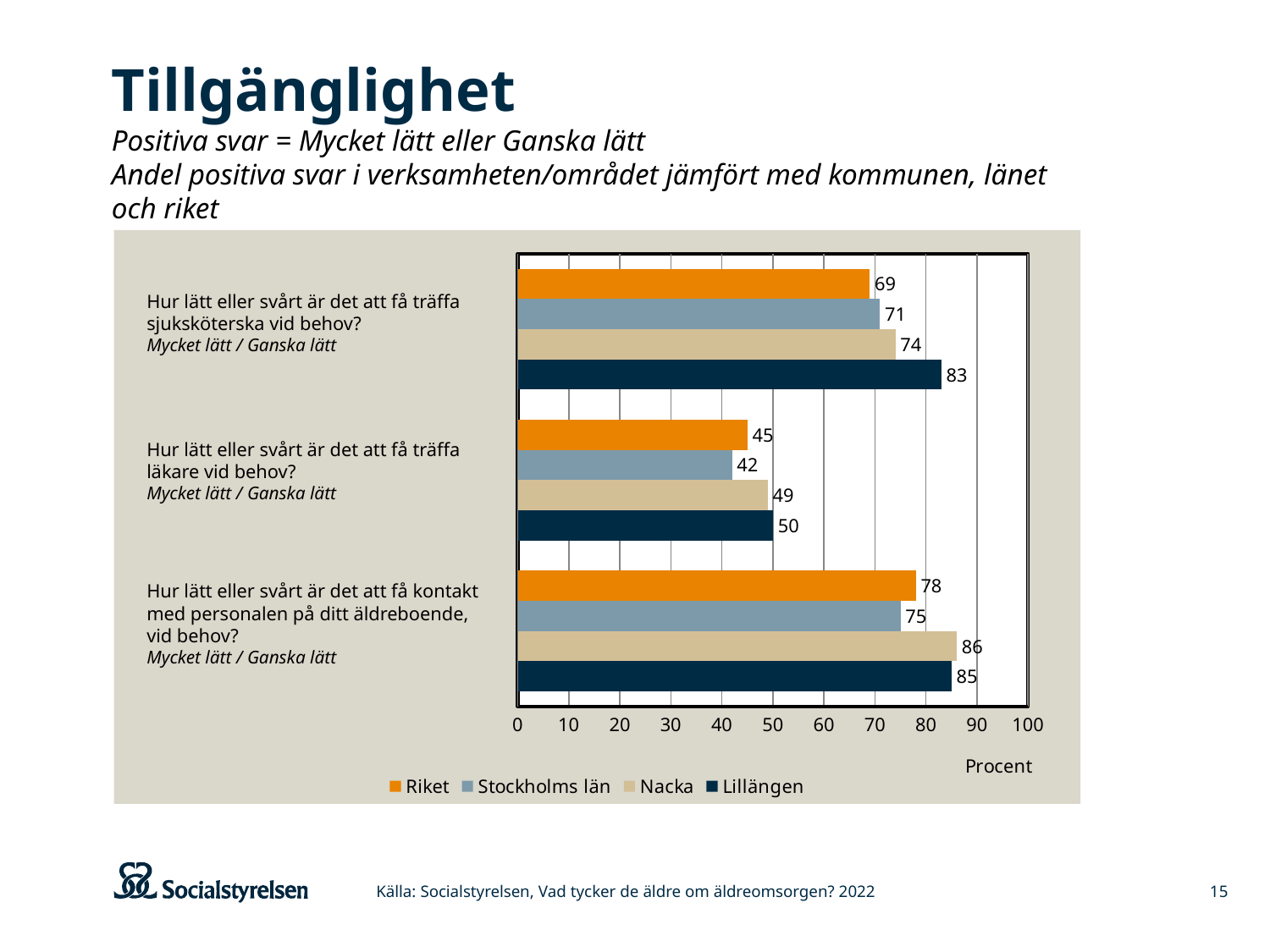
How many questions (categories) are shown in the chart? 3 What is the value for Lillängen on the question about meeting a nurse when needed (sjuksköterska)? 83 What is the value for Nacka on the question about getting in contact with staff at the care home (kontakt med personalen)? 86 What is the value for Riket on the question about meeting a doctor when needed (läkare)? 45 Which is larger on the question about contact with staff at the care home: Nacka or Lillängen? Nacka What is the difference between Lillängen and Riket on the question about meeting a nurse when needed (sjuksköterska)? 14 What unit label is shown below the x axis of the chart? Procent Which series has the lowest value on the question about meeting a nurse when needed (sjuksköterska)? Riket What kind of chart is shown on the slide? bar chart Which series has the highest value on the question about meeting a doctor when needed (läkare)? Lillängen How many series does the legend list? 4 Is the value for Stockholms län on the question about meeting a doctor (läkare) greater or less than 50? less